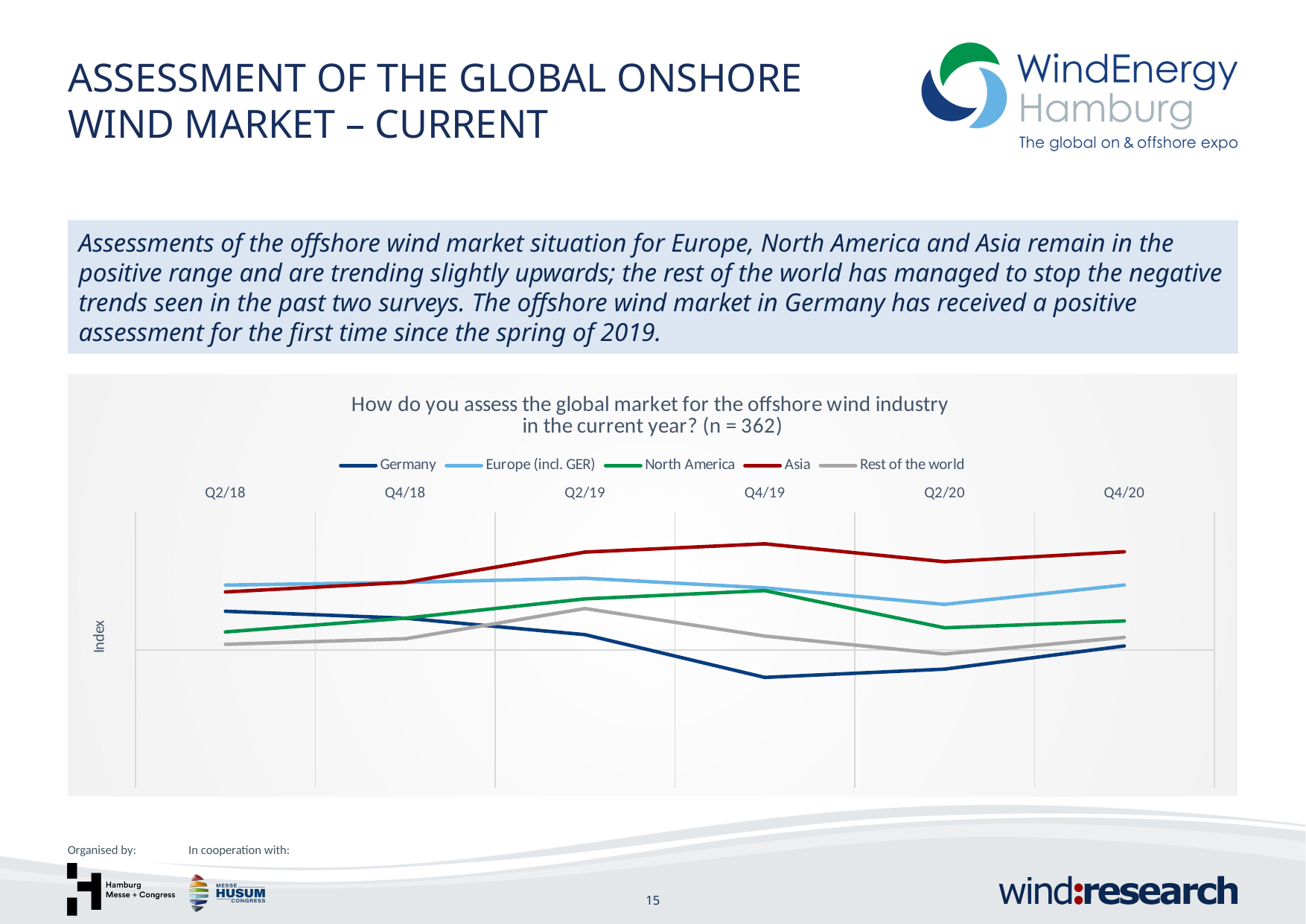
At Q2/20, which is higher: Europe (incl. GER) or North America? Europe (incl. GER) Which series has the highest value at Q4/20? Asia Which series has the highest value at Q4/19? Asia Does the Asia line rise or fall from Q2/18 to Q4/19? rise At Q2/18, which is higher: Germany or North America? Germany Which series has the lowest value at Q4/19? Germany How many series does the chart's legend list? 5 What sample size (n) is given in the chart title? 362 Does the Germany line rise or fall from Q2/18 to Q4/19? fall How many survey periods are shown along the x axis of the chart? 6 What kind of chart is shown on the slide? line chart Which series has the lowest value at Q2/19? Germany